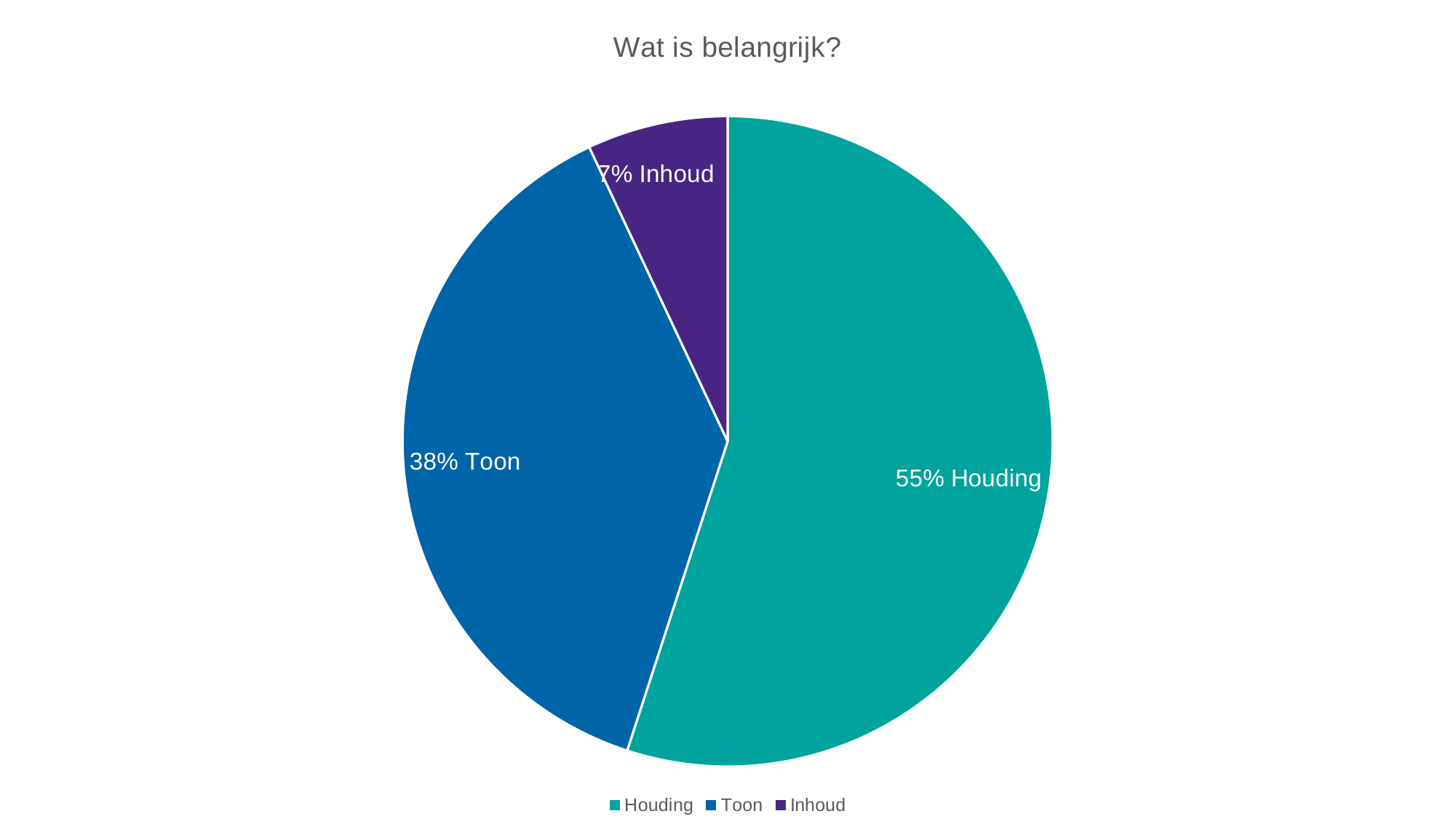
Which category has the largest slice? Houding What is the title of the chart? Wat is belangrijk? What kind of chart is shown on the slide? pie chart Which is larger, the share for Toon or the share for Inhoud? Toon What is the difference in percentage points between Houding and Toon? 17 Which category has the smallest slice? Inhoud What is the difference in percentage points between Toon and Inhoud? 31 What share of the pie does Toon take? 38% How many entries does the legend list? 3 What share of the pie does Houding take? 55% How many slices does the pie chart have? 3 What share of the pie does Inhoud take? 7%